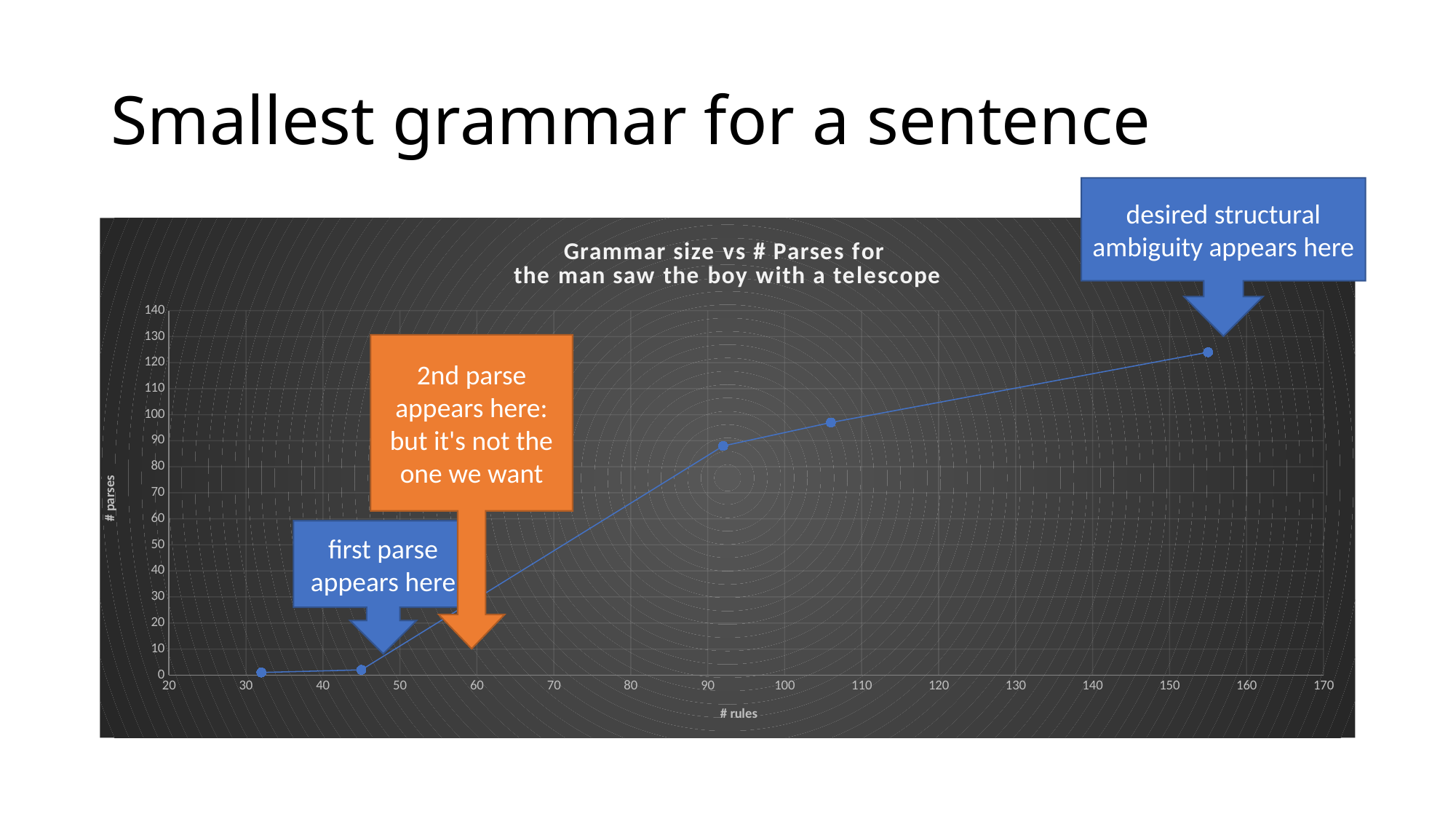
What is the label of the x axis? # rules What is the title of the chart? Grammar size vs # Parses for the man saw the boy with a telescope What is the highest value shown on the y axis? 140 How many data points are plotted on the chart? 5 Is the value of # parses for the data point at around 92 rules greater or less than 100? less Which data point has the lowest number of parses? the leftmost point, at around 32 rules Which data point has the highest number of parses: the one at around 92 rules or the one at around 155 rules? the one at around 155 rules Do the values of # parses rise or fall as # rules increases along the x axis? rise Is the value of # parses for the data point at around 106 rules greater or less than 80? greater What kind of chart is shown on the slide? line chart Is the value of # parses for the rightmost data point (around 155 rules) greater or less than 110? greater